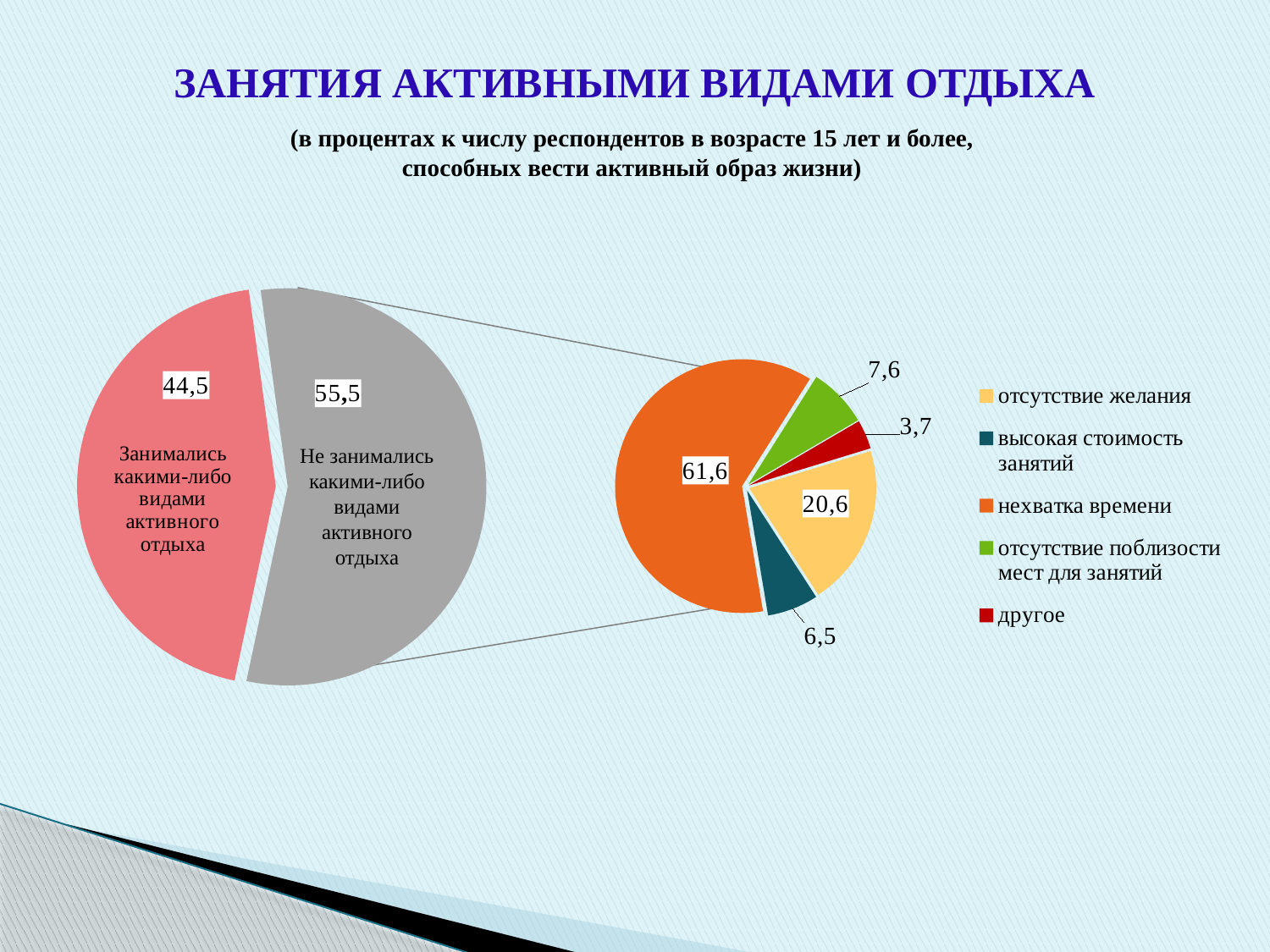
What type of chart is used on the left side of the slide? Pie chart In the right pie chart, what is the value for "нехватка времени"? 61,6 In the left pie chart, what is the value for "Не занимались какими-либо видами активного отдыха"? 55,5 In the right pie chart, what is the value for "отсутствие желания"? 20,6 In the right pie chart, which category has the largest slice? нехватка времени In the right pie chart, which category has the smallest slice? другое In the right pie chart, what is the difference between "нехватка времени" and "отсутствие желания"? 41 In the left pie chart, which slice is larger: "Занимались" or "Не занимались"? Не занимались какими-либо видами активного отдыха How many entries does the legend of the right pie chart list? 5 In the left pie chart, what is the value for "Занимались какими-либо видами активного отдыха"? 44,5 In the left pie chart, what is the difference between the "Не занимались" slice and the "Занимались" slice? 11 In the right pie chart, what is the value for "высокая стоимость занятий"? 6,5